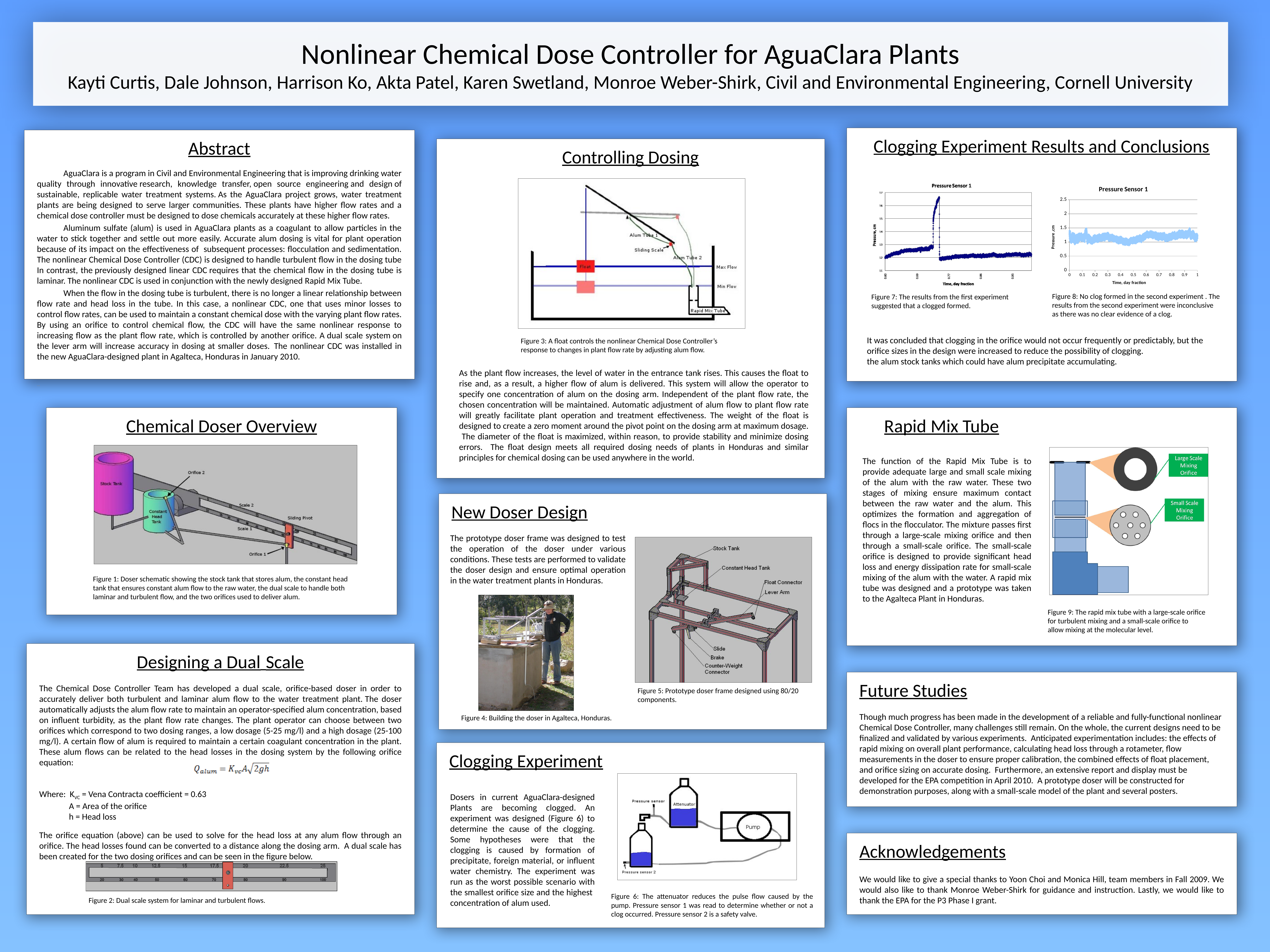
How many charts are shown on the slide? 2 In the Figure 8 chart (Pressure Sensor 1), what is the highest value shown on the y-axis? 2.5 What is the lowest value shown on the y-axis of the Figure 7 chart? 1.1 In the Figure 7 chart (Pressure Sensor 1), is the peak pressure value greater or less than 1.5? greater In the Figure 8 chart (Pressure Sensor 1), are the plotted pressure values greater or less than 0.5? greater In the Figure 8 chart (Pressure Sensor 1), do the pressure values show a clear rising or falling trend, or stay roughly flat across the time axis? roughly flat What is the title of the chart in Figure 7? Pressure Sensor 1 In the Figure 7 chart (Pressure Sensor 1), are the pressure values at the start of the series greater or less than 1.3? less